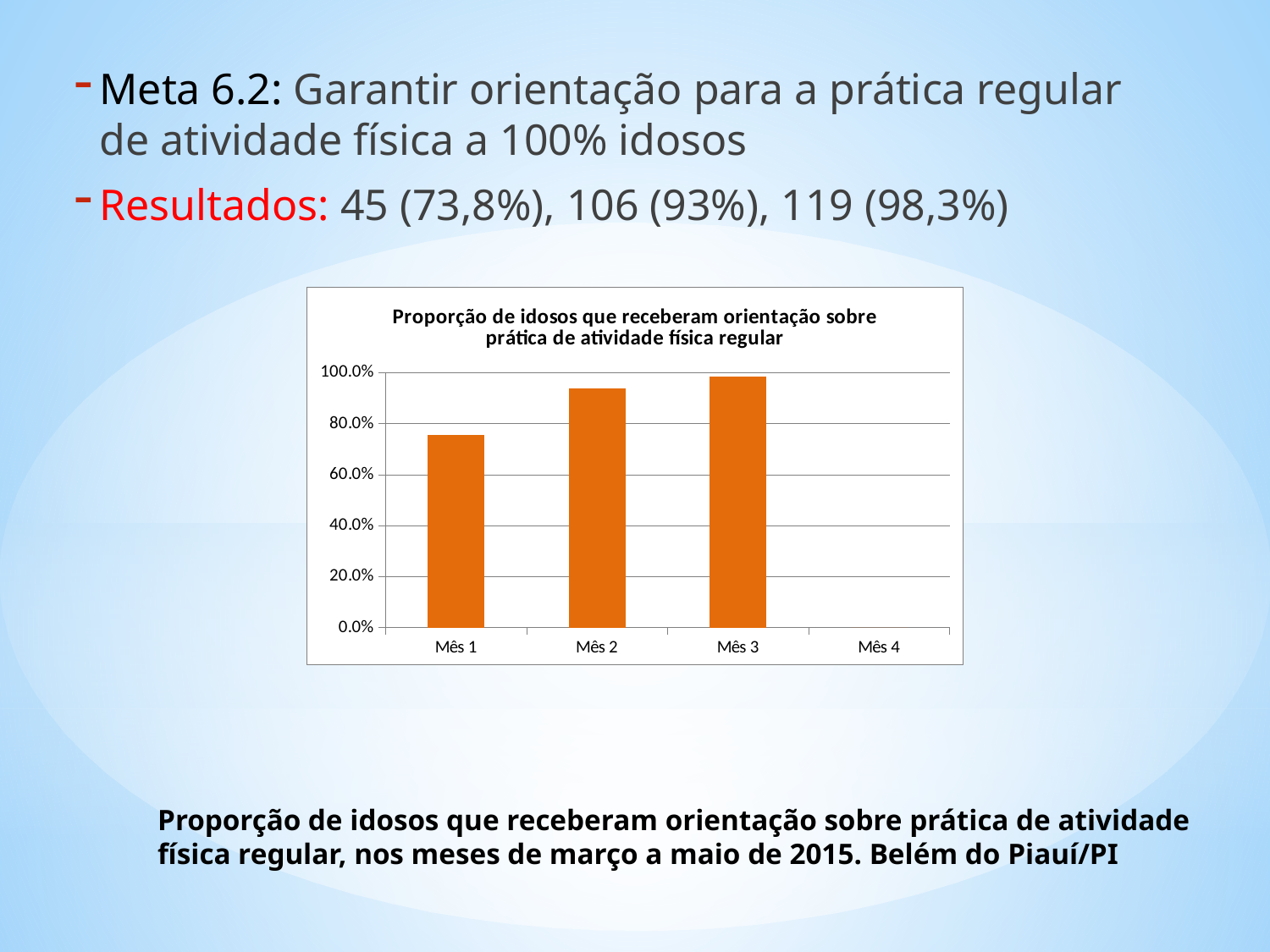
What is the title of the chart? Proporção de idosos que receberam orientação sobre prática de atividade física regular Which is larger, the value for Mês 1 or the value for Mês 2? Mês 2 Is the value for Mês 3 greater or less than 80.0%? greater Do the bar values rise or fall from Mês 1 to Mês 3? rise How many categories are labelled on the x axis of the chart? 4 How many bars are plotted in the chart? 3 What kind of chart is shown on the slide? bar chart What colour are the bars in the chart? orange Is the value for Mês 2 greater or less than 80.0%? greater Which month has the highest bar in the chart? Mês 3 Is the value for Mês 1 greater or less than 80.0%? less Among the months with a plotted bar, which has the lowest value? Mês 1